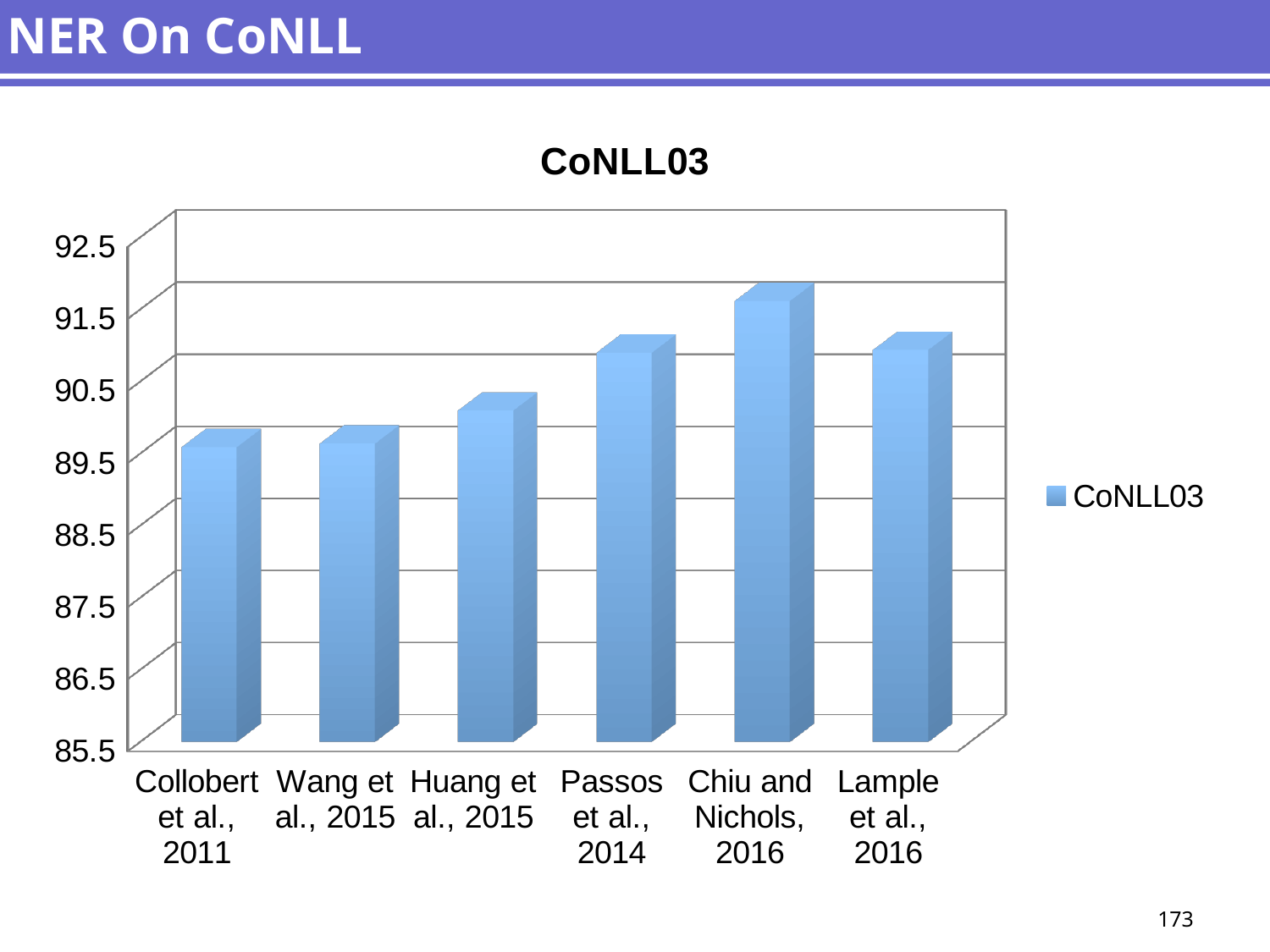
Which is larger, the value for Passos et al., 2014 or the value for Wang et al., 2015? Passos et al., 2014 Is the value for Huang et al., 2015 greater or less than 89.5? greater What kind of chart is shown on the slide? bar chart Is the value for Wang et al., 2015 greater or less than 90.5? less Which system has the highest CoNLL03 score? Chiu and Nichols, 2016 Which is larger, the value for Chiu and Nichols, 2016 or the value for Huang et al., 2015? Chiu and Nichols, 2016 Is the value for Chiu and Nichols, 2016 greater or less than 90.5? greater How many series does the legend list? 1 What is the title of the chart? CoNLL03 How many categories (systems) are plotted on the x axis? 6